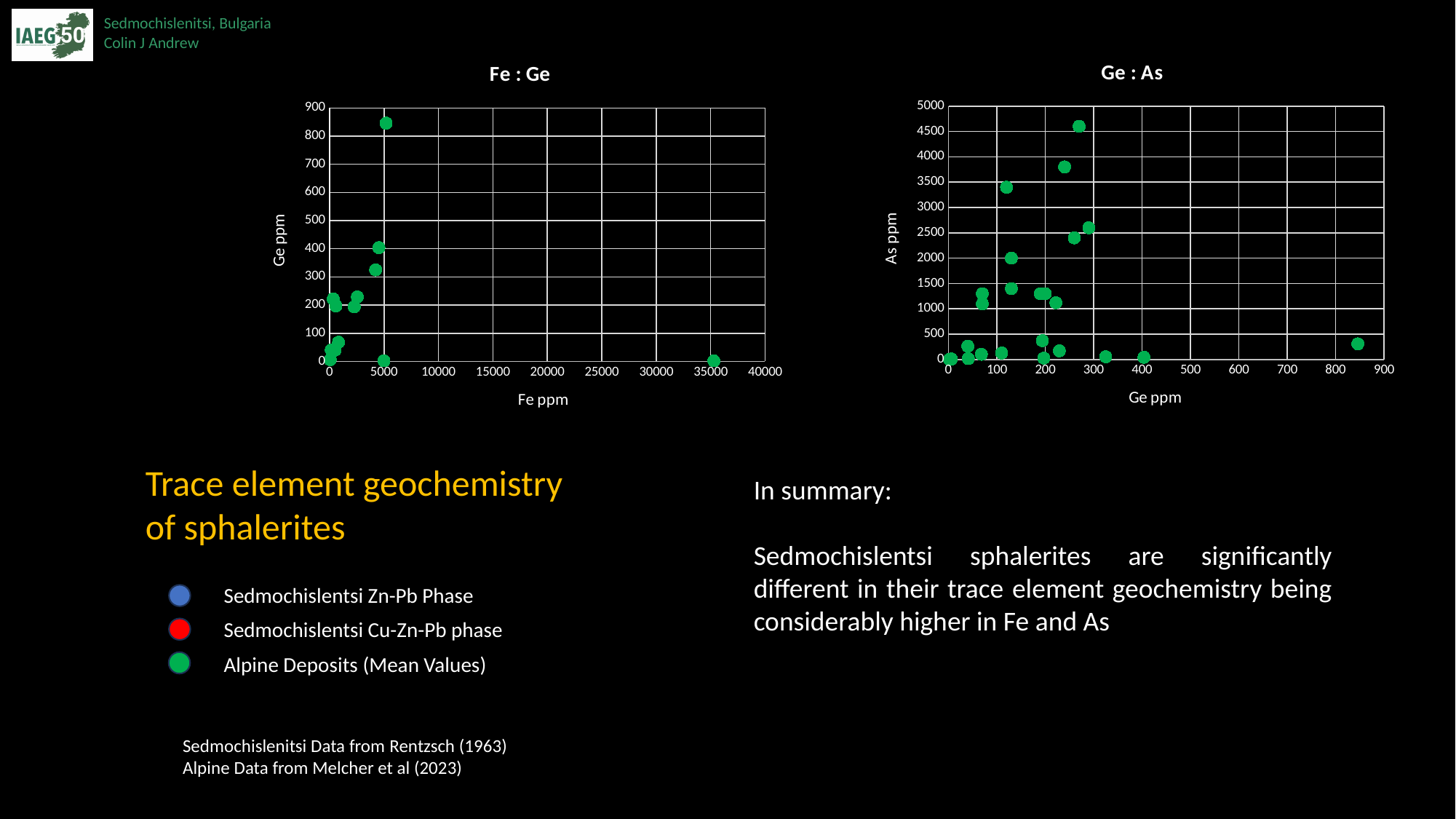
In the Fe : Ge chart, is the Ge value of the highest point greater or less than 800? greater In the Fe : Ge chart, what is the label on the x axis? Fe ppm In the Ge : As chart, is the Ge value of the rightmost point greater or less than 800? greater In the Fe : Ge chart, which has the larger Ge value: the point at about 5000 Fe ppm near the top of the chart or the point at about 35000 Fe ppm? The point at about 5000 Fe ppm What kind of chart is the Ge : As chart? Scatter chart What kind of chart is the Fe : Ge chart? Scatter chart In the Fe : Ge chart, is the Fe value of the highest point greater or less than 10000? less In the Ge : As chart, which has the larger As value: the point at about 270 Ge ppm near the top of the chart or the point at about 850 Ge ppm? The point at about 270 Ge ppm In the Ge : As chart, what is the label on the y axis? As ppm